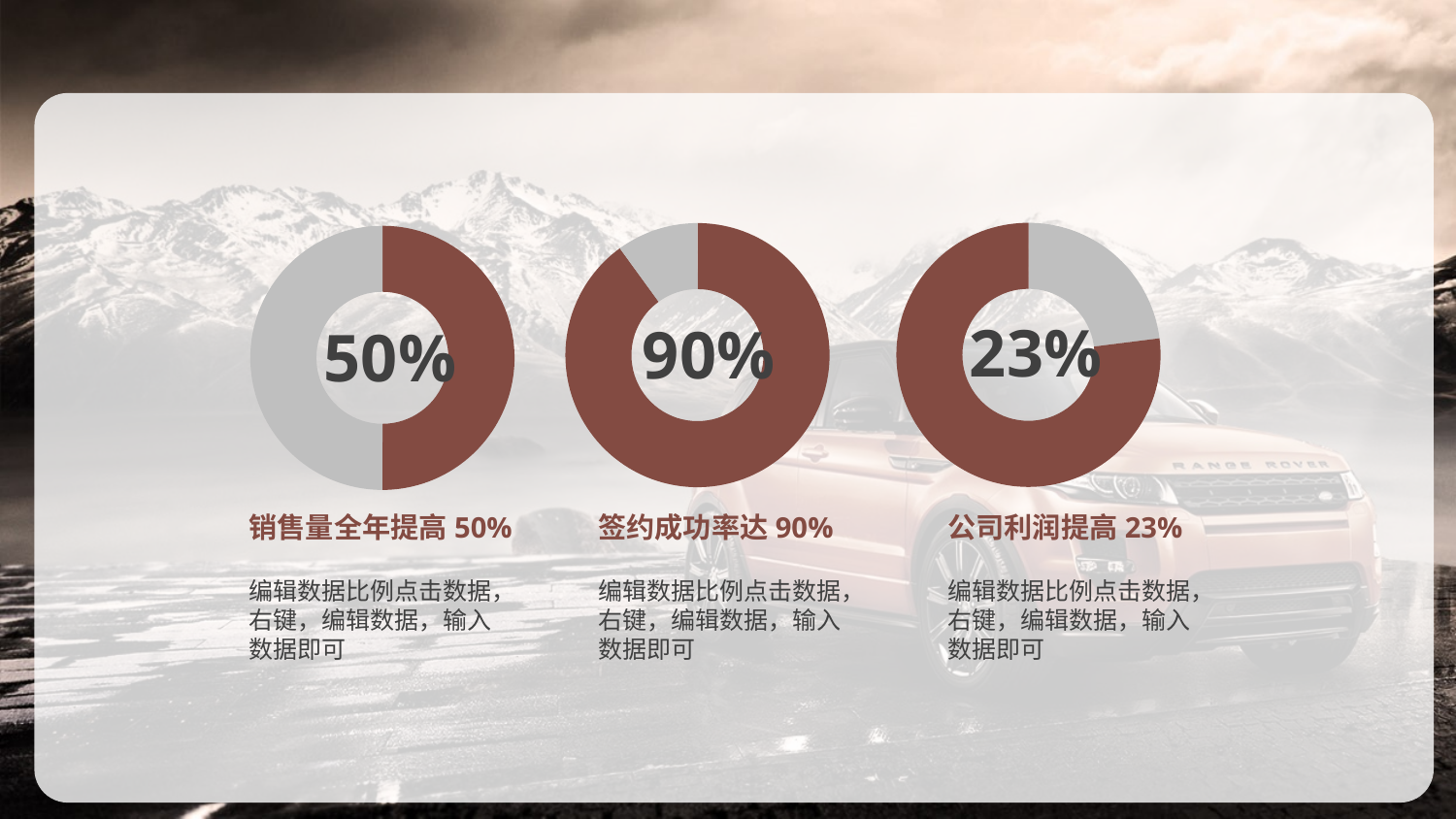
Which of the three donut charts shows the highest percentage? 签约成功率达 90% What is the difference between the percentage in the middle chart (90%) and the left chart (50%)? 40% How many donut charts are on the slide? 3 What is the caption under the middle donut chart? 签约成功率达 90% What percentage is shown in the centre of the middle donut chart (签约成功率达)? 90% What percentage is shown in the centre of the left donut chart (销售量全年提高)? 50% Which of the three donut charts shows the lowest percentage? 公司利润提高 23% What percentage is shown in the centre of the right donut chart (公司利润提高)? 23% What kind of charts are shown on the slide? Donut (pie) charts What is the difference between the percentage in the left chart (50%) and the right chart (23%)? 27% Which is larger, the percentage in the left chart (销售量全年提高) or the right chart (公司利润提高)? The left chart (50%) What colour is the filled (highlighted) portion of each donut chart? Dark red / brown